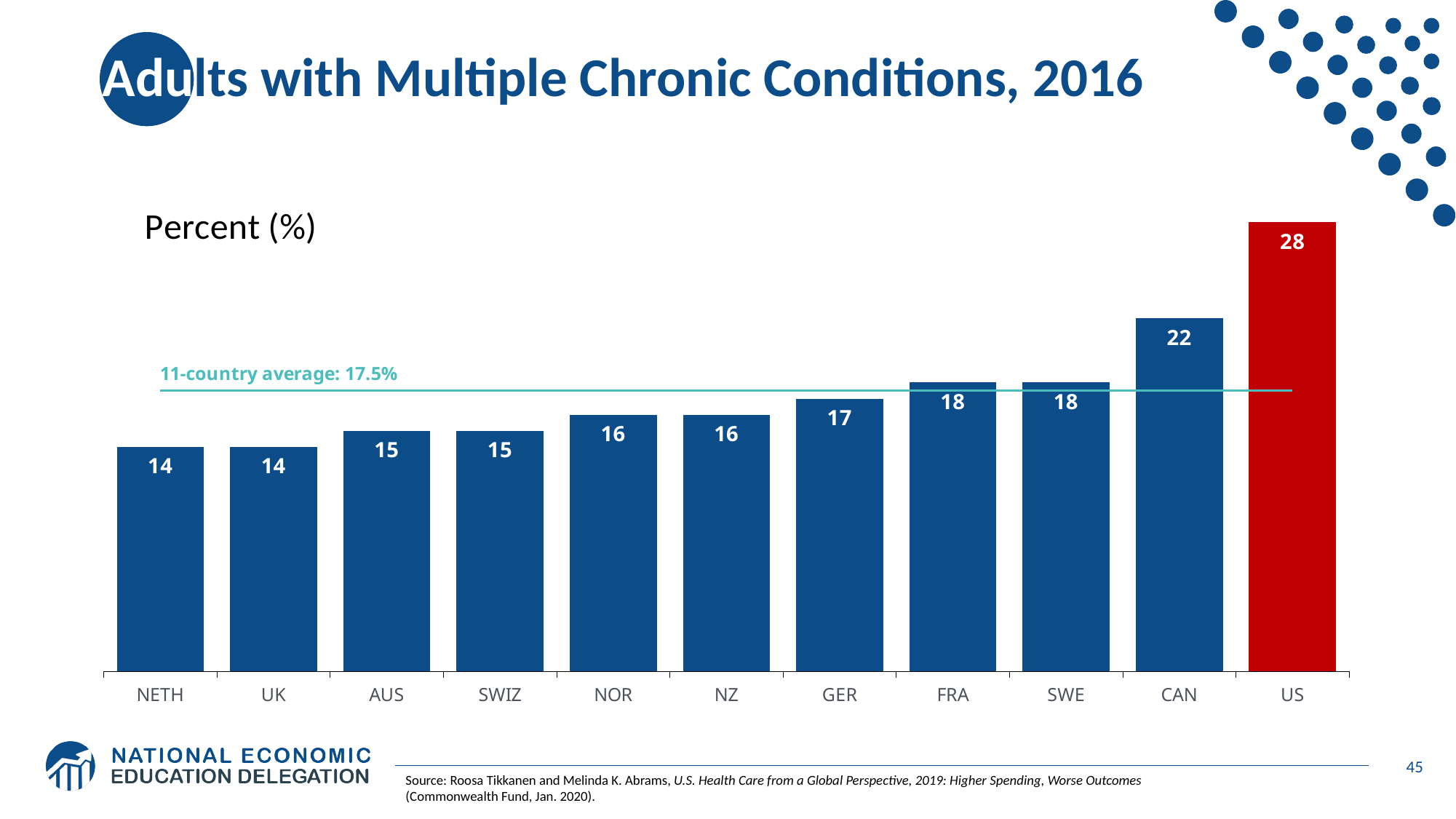
What is the value for GER? 17 What is the 11-country average shown on the chart? 17.5% How many countries are shown on the chart? 11 What is the value for CAN? 22 What is the difference between the values for FRA and NETH? 4 Which country's bar is coloured red? US What kind of chart is shown on the slide? bar chart What is the value for the US? 28 Which country has the highest value? US Do the values rise or fall from left to right across the countries? rise Which is larger, the value for NOR or the value for SWE? SWE What is the difference between the values for the US and CAN? 6